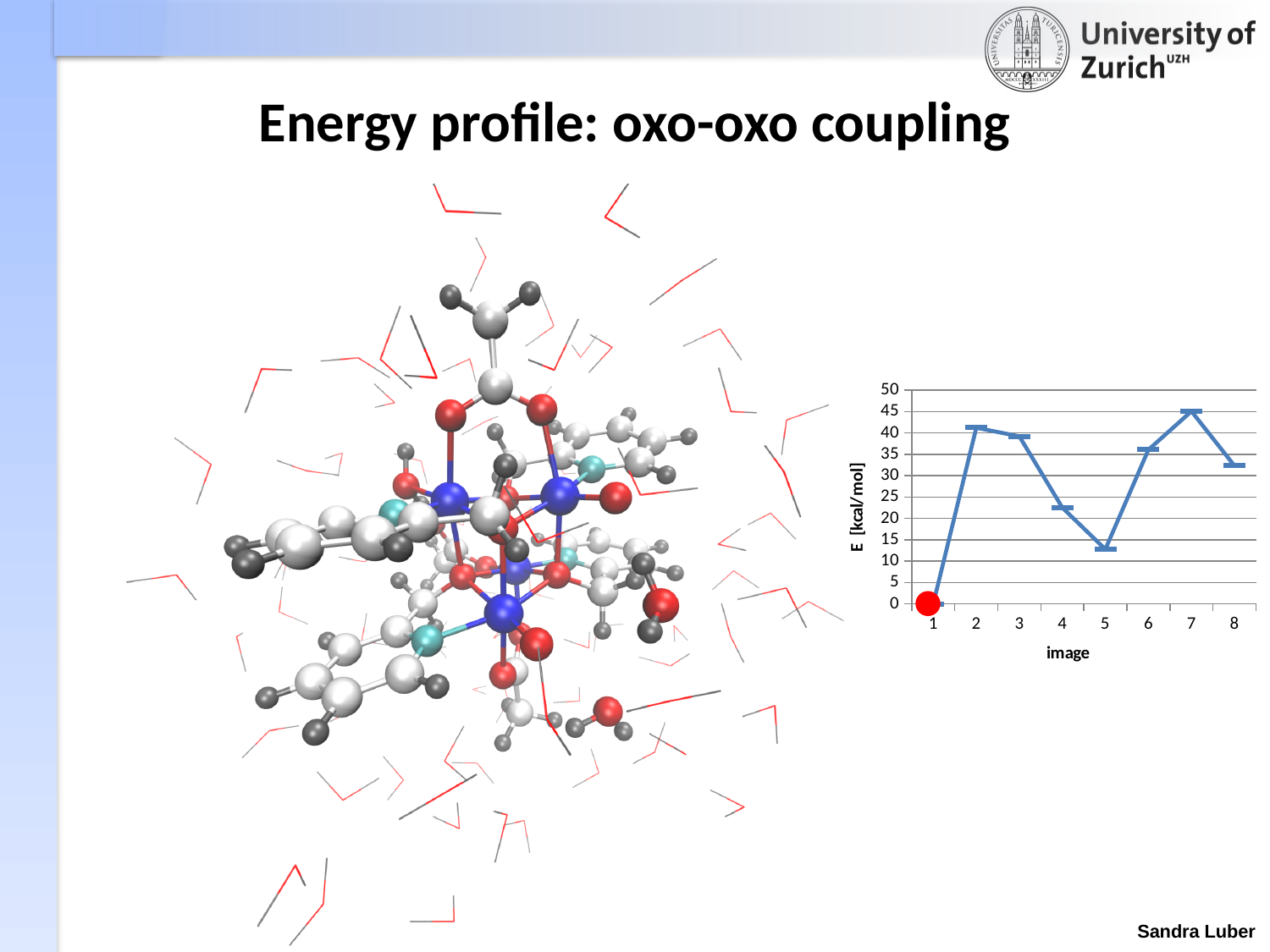
Is the energy for image 4 greater or less than 20 kcal/mol? greater What is the label of the y axis? E [kcal/mol] Which image has the lowest energy? 1 Which has a higher energy, image 6 or image 8? image 6 What kind of chart is shown on the slide? line chart How many images (data points) are plotted along the x axis? 8 Is the energy for image 5 greater or less than 15 kcal/mol? less What is the label of the x axis? image Does the energy rise or fall from image 2 to image 5? fall What is the energy value for image 1? 0 Which image has the highest energy? 7